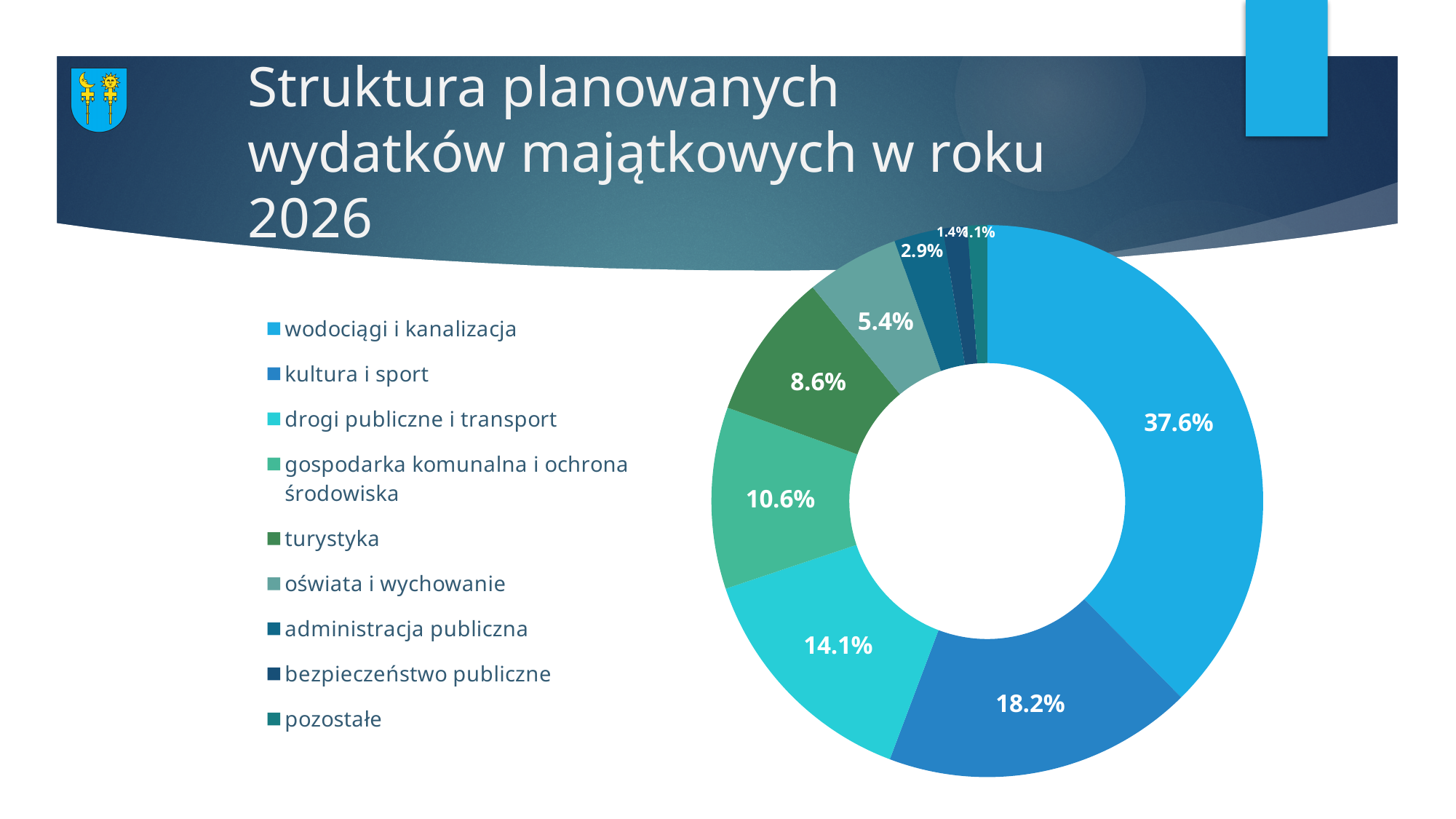
What share of planned capital expenditure in 2026 goes to wodociągi i kanalizacja? 37.6% What percentage does turystyka account for? 8.6% What is the value for oświata i wychowanie? 5.4% What share is shown for gospodarka komunalna i ochrona środowiska? 10.6% What percentage is shown for kultura i sport? 18.2% Which is larger: the share for turystyka or the share for oświata i wychowanie? turystyka What percentage is shown for administracja publiczna? 2.9% Which category has the largest share of the chart? wodociągi i kanalizacja What type of chart is shown on the slide? pie chart (doughnut) How many categories does the legend list? 9 What is the difference in percentage points between wodociągi i kanalizacja and kultura i sport? 19.4 What is the value for drogi publiczne i transport? 14.1%